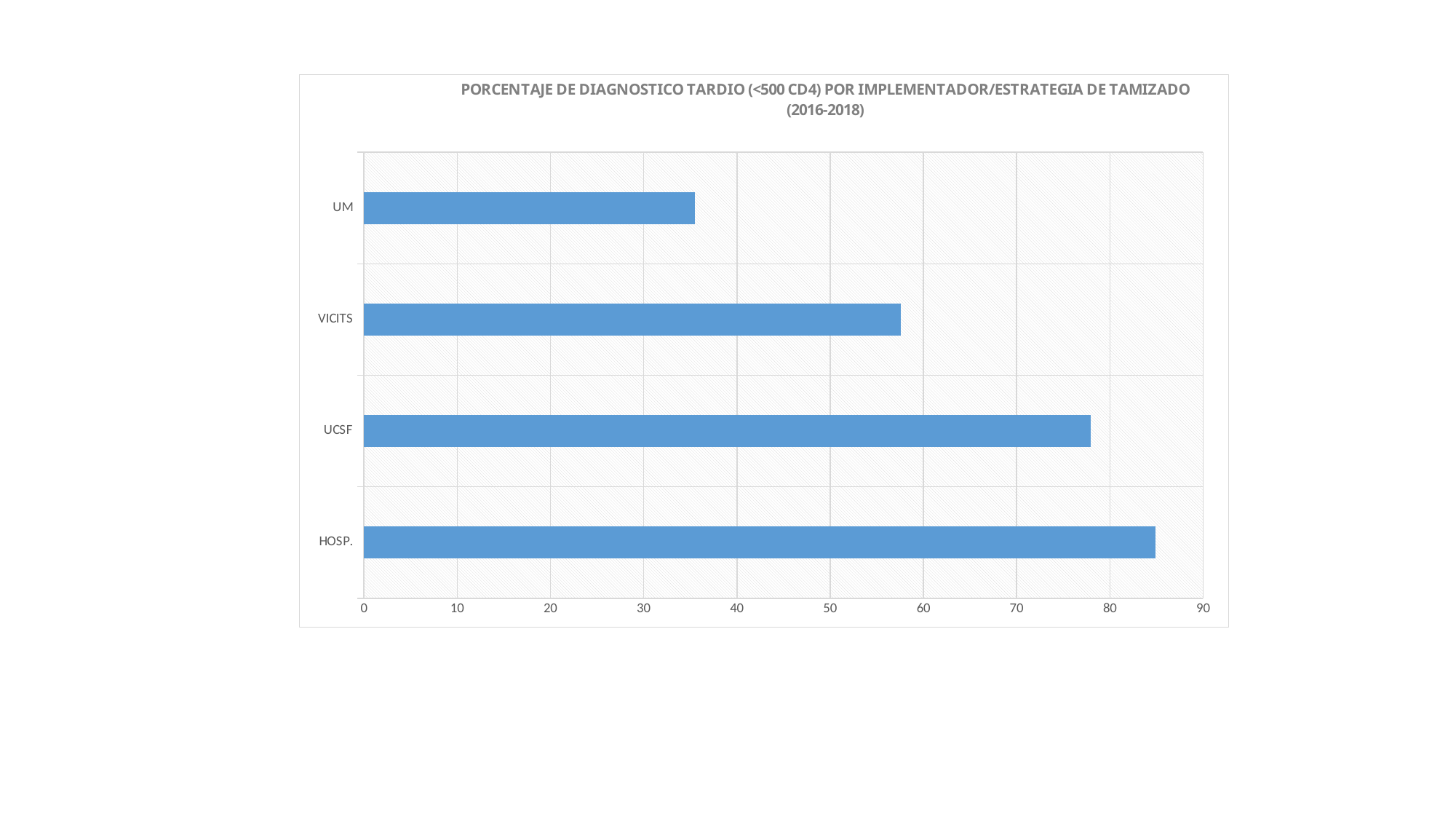
What period is given in the chart title? 2016-2018 Which has a larger value, UCSF or VICITS? UCSF Which has a larger value, UM or HOSP.? HOSP. Is the value for UCSF greater or less than 70? greater How many categories are plotted in the chart? 4 Which category has the lowest value? UM Is the value for UM greater or less than 40? less Is the value for HOSP. greater or less than 80? greater What kind of chart is shown on the slide? bar chart Which category has the highest value? HOSP. What is the maximum value shown on the horizontal axis? 90